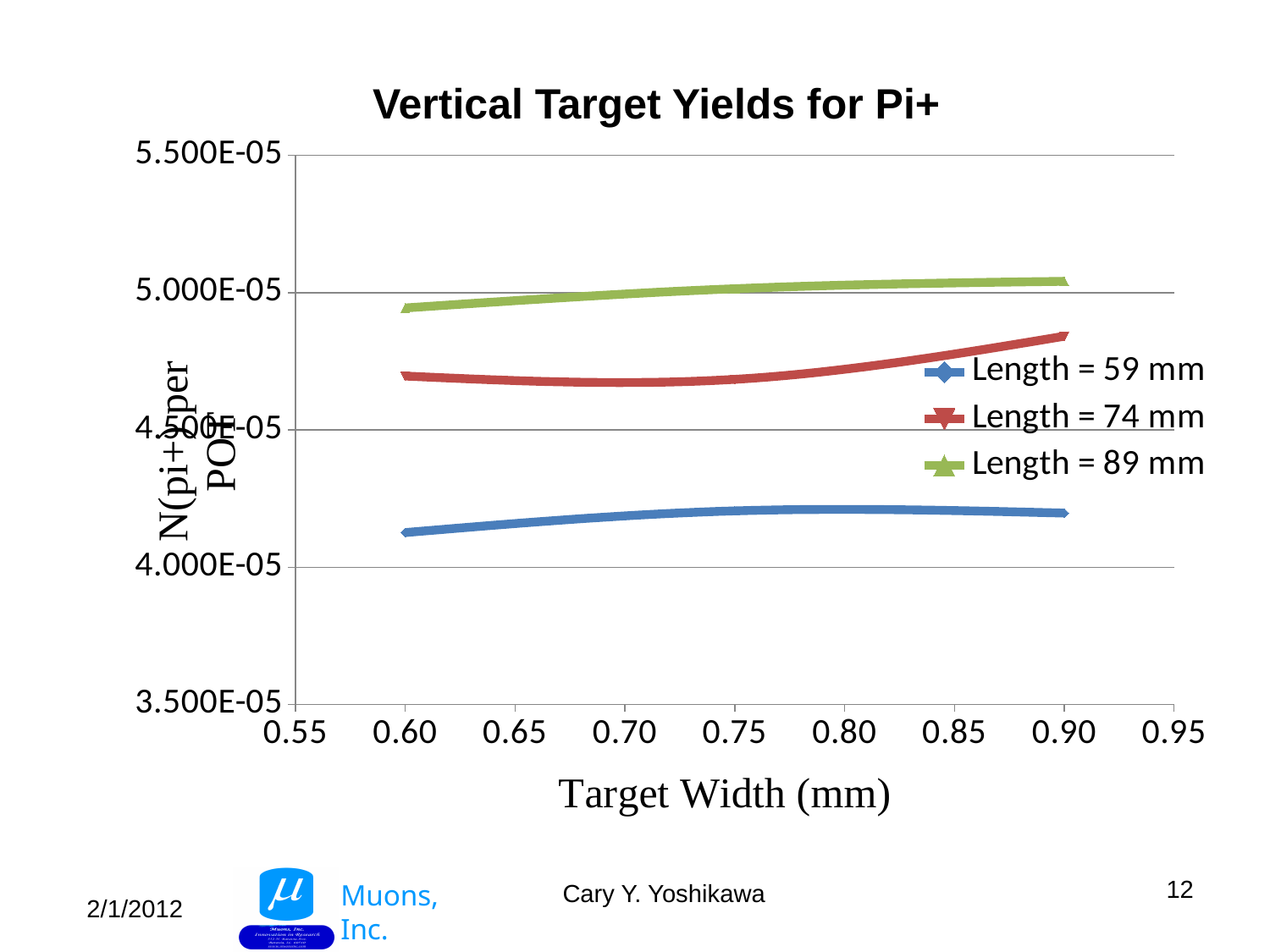
Do the values for Length = 89 mm rise or fall as target width increases from 0.60 to 0.90? rise Is the value for Length = 74 mm at a target width of 0.60 greater or less than 4.500E-05? greater What kind of chart is shown on the slide? line chart What is the title of the chart? Vertical Target Yields for Pi+ At a target width of 0.90, which is larger: the value for Length = 74 mm or Length = 59 mm? Length = 74 mm Which series has the lowest values across the chart? Length = 59 mm Is the value for Length = 59 mm at a target width of 0.90 greater or less than 4.500E-05? less Is the value for Length = 59 mm at a target width of 0.60 greater or less than 4.000E-05? greater Which series has the highest values across the chart? Length = 89 mm What is the x-axis title of the chart? Target Width (mm) How many series does the legend list? 3